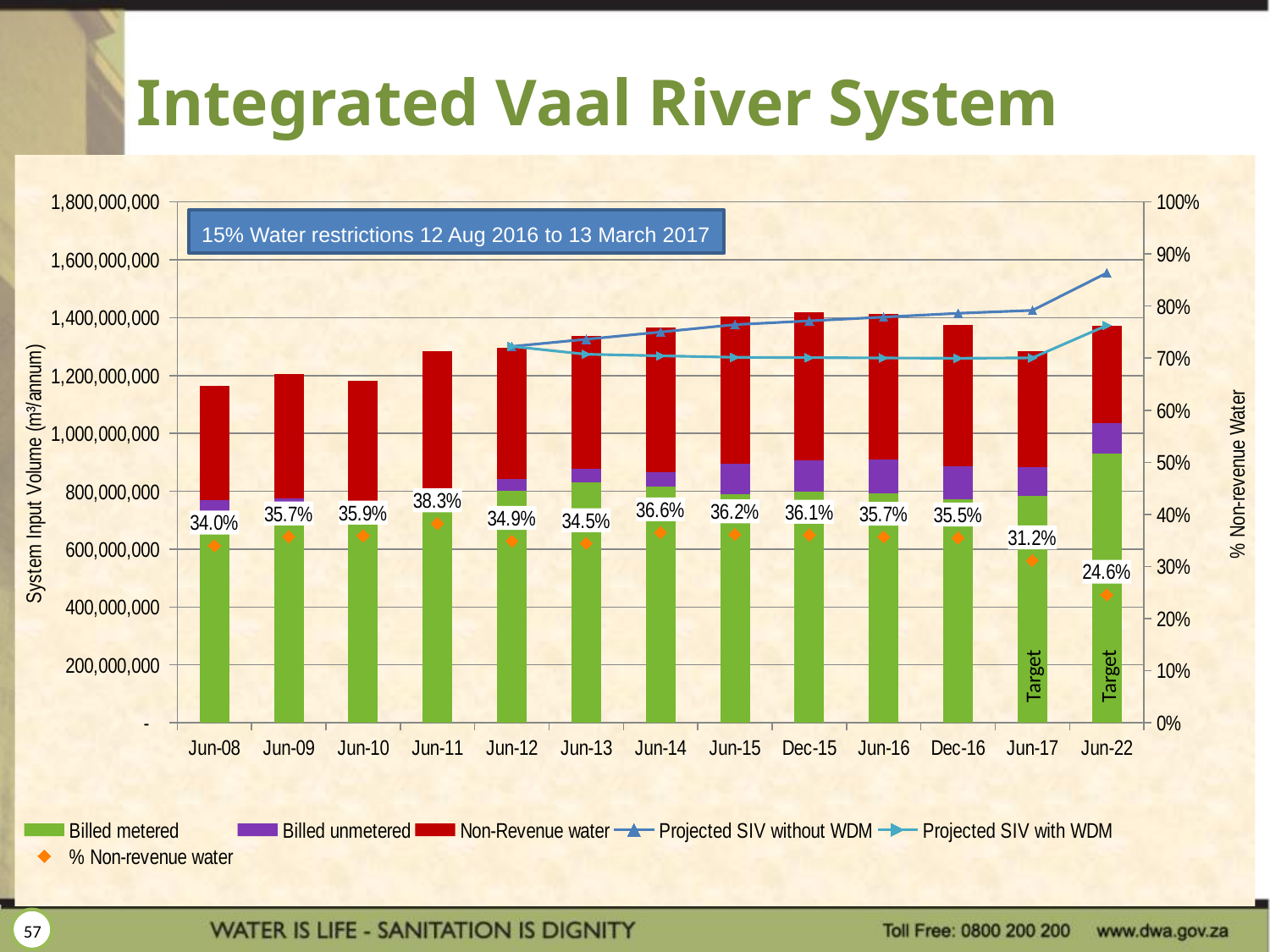
What is the difference in % Non-revenue water between Jun-11 and Jun-22? 13.7% How many series does the legend list? 6 How many periods are shown on the x axis? 13 Is the total System Input Volume bar for Dec-15 greater or less than 1,400,000,000? greater What is the % Non-revenue water value for Jun-11? 38.3% What is the % Non-revenue water value for Jun-22? 24.6% Which has a higher % Non-revenue water, Jun-14 or Jun-13? Jun-14 Is the total System Input Volume bar for Jun-08 greater or less than 1,200,000,000? less What does the text box on the chart say? 15% Water restrictions 12 Aug 2016 to 13 March 2017 What is the % Non-revenue water value for Dec-15? 36.1% Which period has the highest % Non-revenue water? Jun-11 Which period has the lowest % Non-revenue water? Jun-22